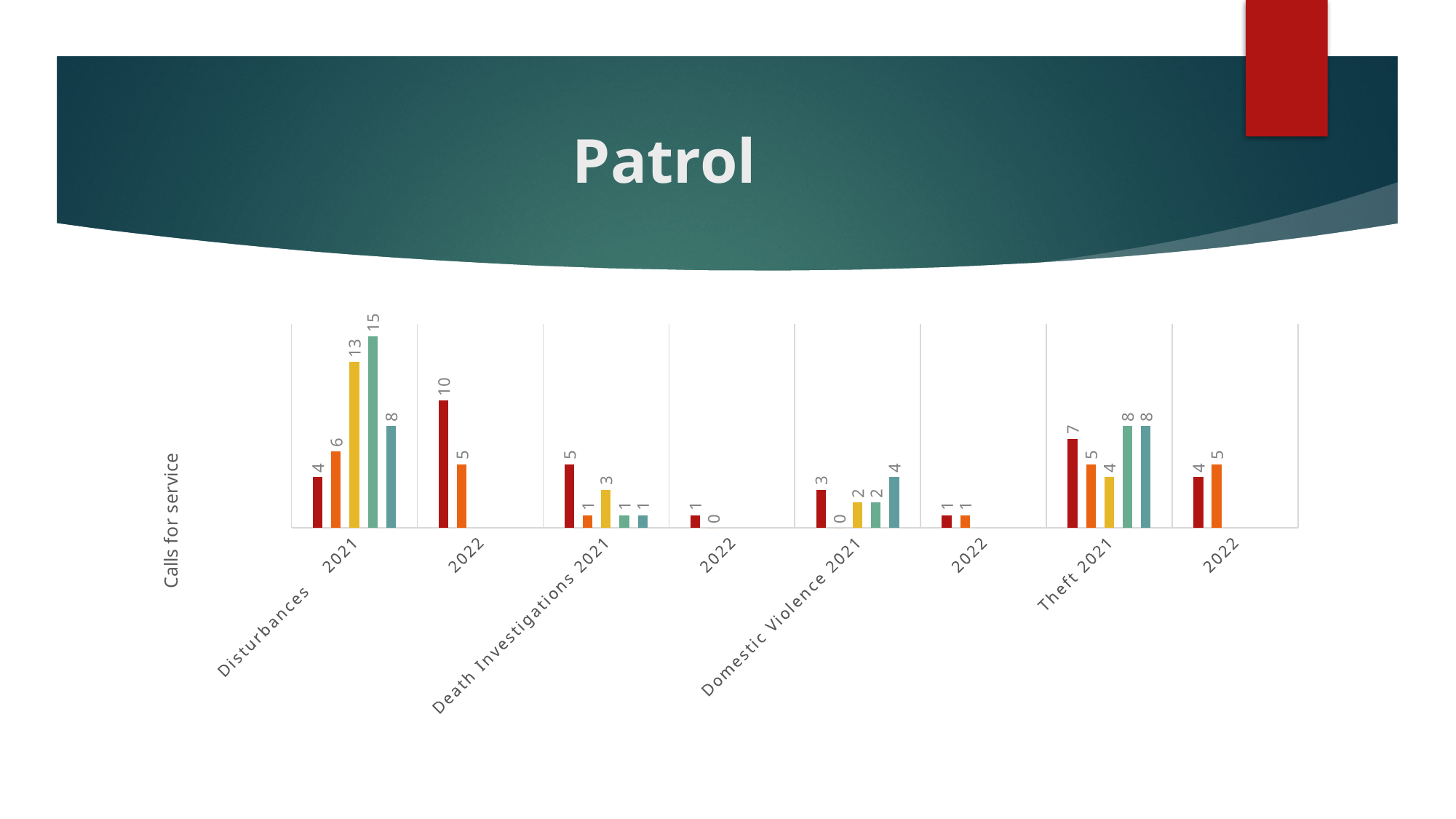
How many category groups are shown along the x axis of the chart? 8 What is the value of the dark red bar for Disturbances 2022? 10 What is the label on the vertical axis of the chart? Calls for service What is the value of the yellow bar for Disturbances 2021? 13 What is the highest value labelled anywhere on the chart? 15 What is the value of the dark red bar for Theft 2021? 7 What is the difference between the dark red bar for Disturbances 2022 and the orange bar for Disturbances 2022? 5 In which category group does the tallest bar on the chart appear? Disturbances 2021 What is the value of the orange bar for Death Investigations 2022? 0 What kind of chart is shown on the slide? bar chart What is the value of the orange bar for Theft 2022? 5 Which is larger: the dark red bar for Death Investigations 2021 or the dark red bar for Domestic Violence 2021? Death Investigations 2021